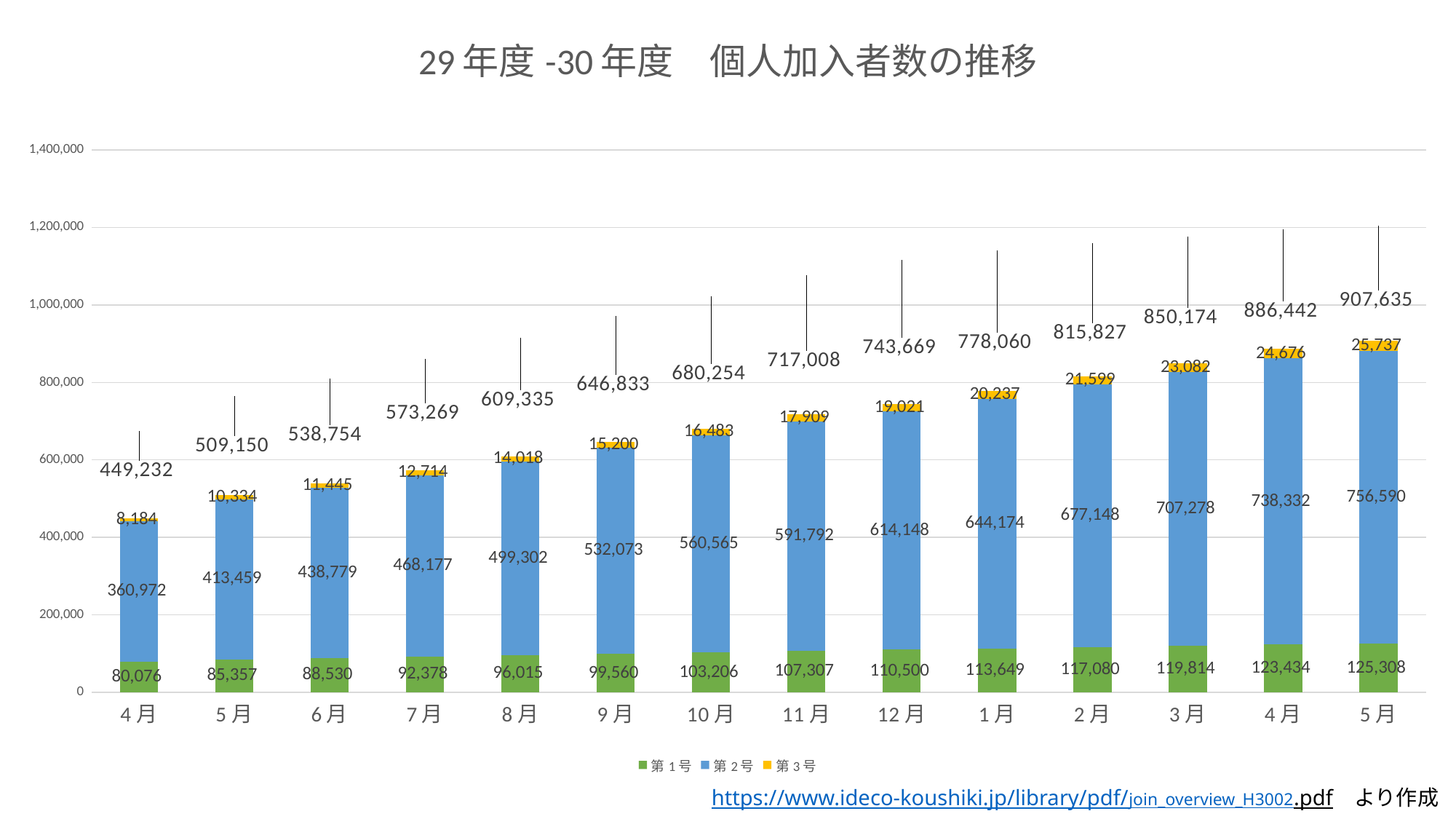
What kind of chart is shown on the slide? Stacked bar chart What colour represents 第2号 in the legend? Blue How many series does the legend list? 3 What is the total labelled above the 1月 bar? 778,060 What is the 第1号 value for 12月? 110,500 Do the bar totals rise or fall from left to right across the months? Rise How many monthly bars are plotted in the chart? 14 What is the 第2号 value for 10月? 560,565 Which is larger: the 第2号 value for 7月 or for 8月? 8月 What is the difference between the 第2号 values for 3月 and 2月? 30,130 Which bar has the highest total? 5月 (the rightmost bar), 907,635 What is the 第3号 value for 8月? 14,018